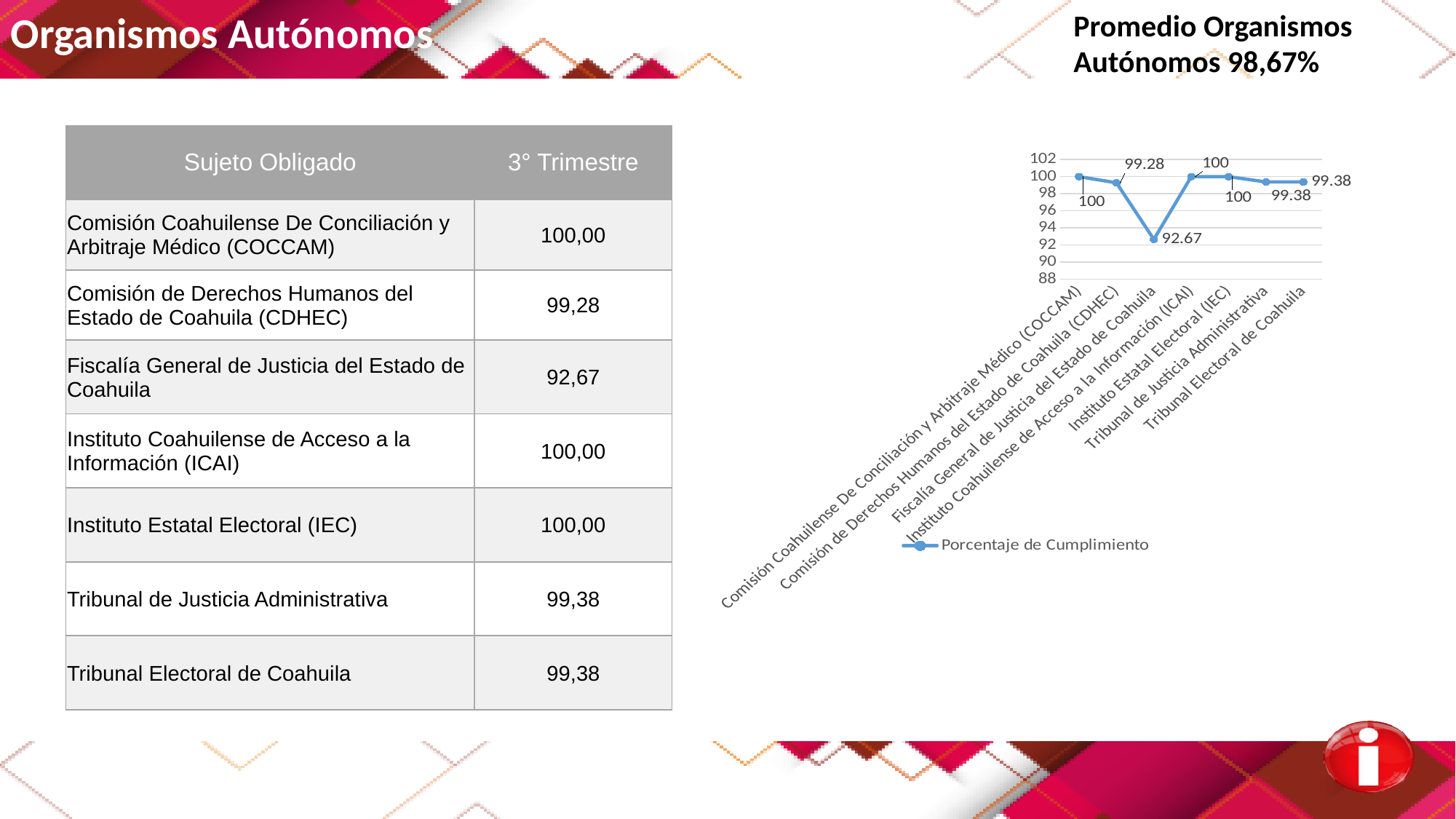
What is the difference between the value for Instituto Coahuilense de Acceso a la Información (ICAI) and the value for Fiscalía General de Justicia del Estado de Coahuila? 7.33 Which category has the lowest value in the chart? Fiscalía General de Justicia del Estado de Coahuila What is the name of the series shown in the chart legend? Porcentaje de Cumplimiento Is the value for Fiscalía General de Justicia del Estado de Coahuila greater or less than 94? less What is the value plotted for Instituto Estatal Electoral (IEC)? 100 What kind of chart is shown on the slide? line chart What is the value plotted for Tribunal Electoral de Coahuila? 99.38 What is the value plotted for Fiscalía General de Justicia del Estado de Coahuila? 92.67 How many series does the chart legend list? 1 How many categories are plotted on the x axis of the chart? 7 What is the value plotted for Comisión de Derechos Humanos del Estado de Coahuila (CDHEC)? 99.28 Which is larger, the value for Comisión de Derechos Humanos del Estado de Coahuila (CDHEC) or the value for Fiscalía General de Justicia del Estado de Coahuila? Comisión de Derechos Humanos del Estado de Coahuila (CDHEC)